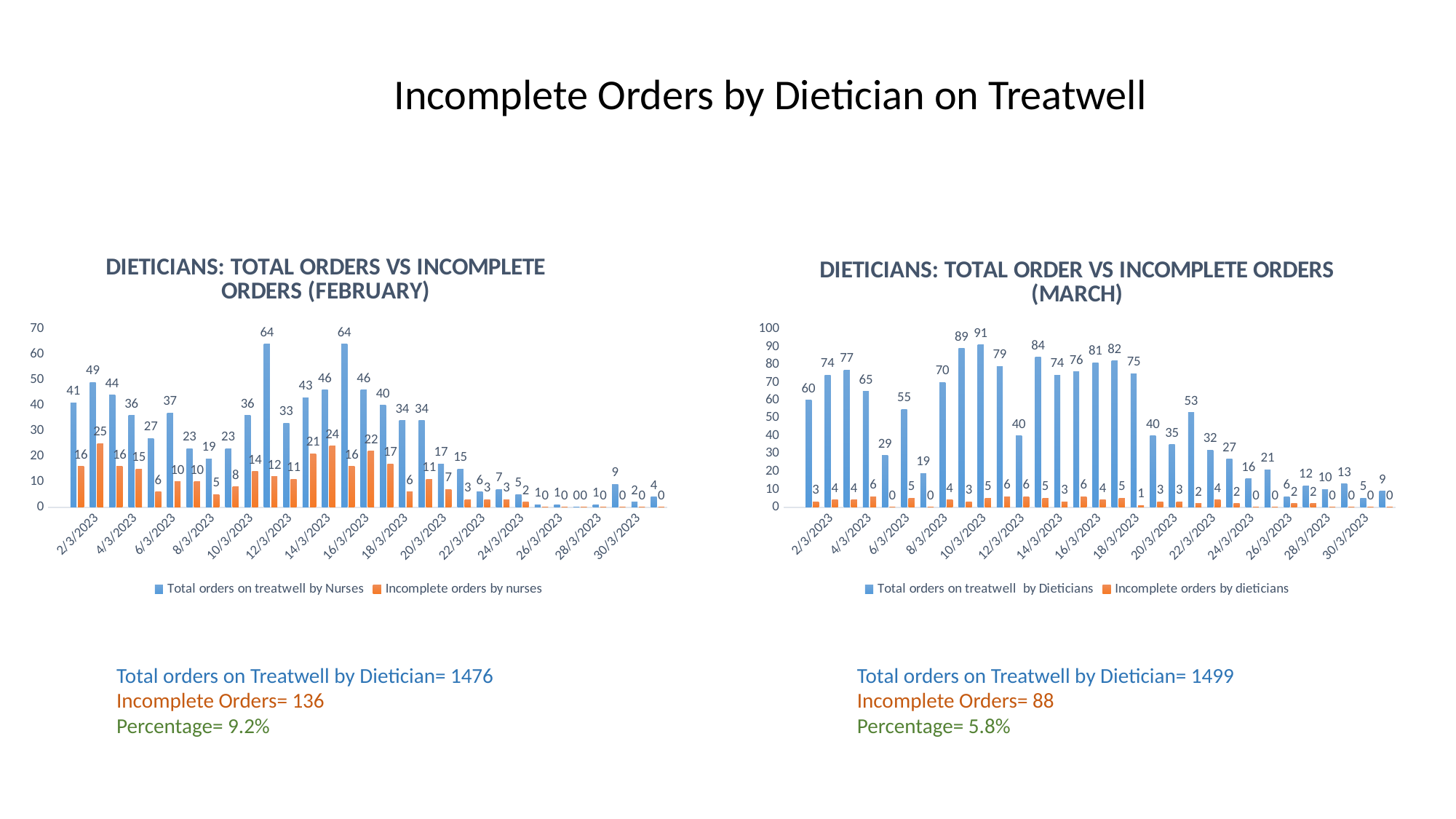
What are the two legend entries of the February chart on the left? Total orders on treatwell by Nurses; Incomplete orders by nurses In the February chart on the left, what is the highest value for total orders? 64 Which chart has the higher peak total orders value, the February chart on the left or the March chart on the right? the March chart on the right In the March chart on the right, what is the lowest value for total orders by dieticians? 5 In the February chart on the left, what is the value of the first blue bar (total orders)? 41 In the March chart on the right, do the total orders values generally rise or fall toward the end of the x axis? fall In the March chart on the right, what is the difference between the highest total orders value (91) and the lowest total orders value (5)? 86 In the March chart on the right, what is the highest value for total orders by dieticians? 91 In the February chart on the left, what is the highest value for incomplete orders? 25 In the March chart on the right, what is the value of the first blue bar (total orders)? 60 What kind of chart is the February chart on the left? bar chart How many series does the legend of the March chart on the right list? 2